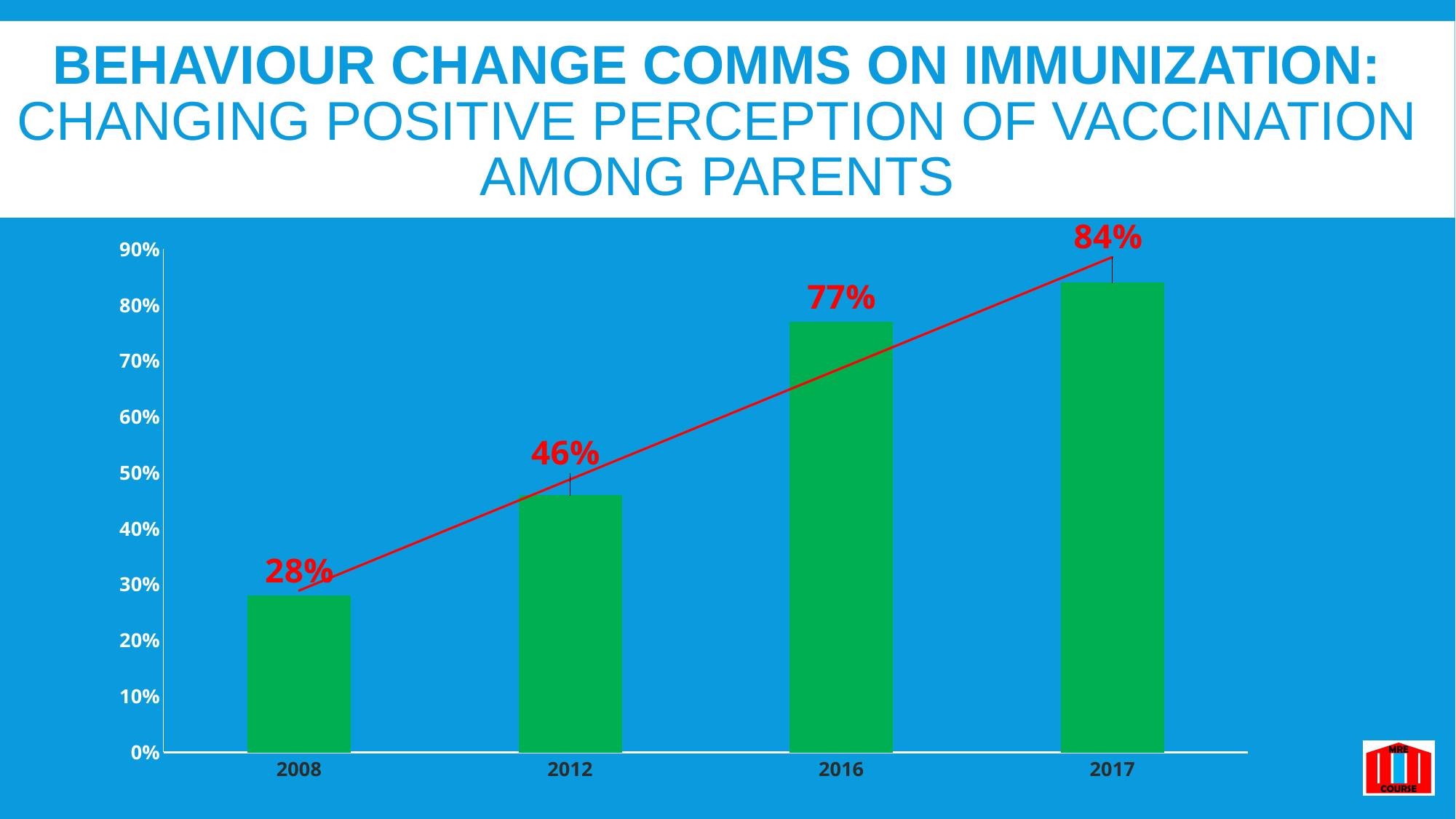
What is the value shown for 2008? 28% Which year has the highest value? 2017 Do the values rise or fall from 2008 to 2017? Rise What is the value shown for 2016? 77% Which year has the lowest value? 2008 What is the difference between the values for 2016 and 2012? 31% Which is larger, the value for 2012 or the value for 2016? 2016 What is the value shown for 2012? 46% What is the value shown for 2017? 84% What kind of chart is shown on the slide? Bar chart What is the difference between the values for 2017 and 2008? 56% How many years are shown on the x axis? 4